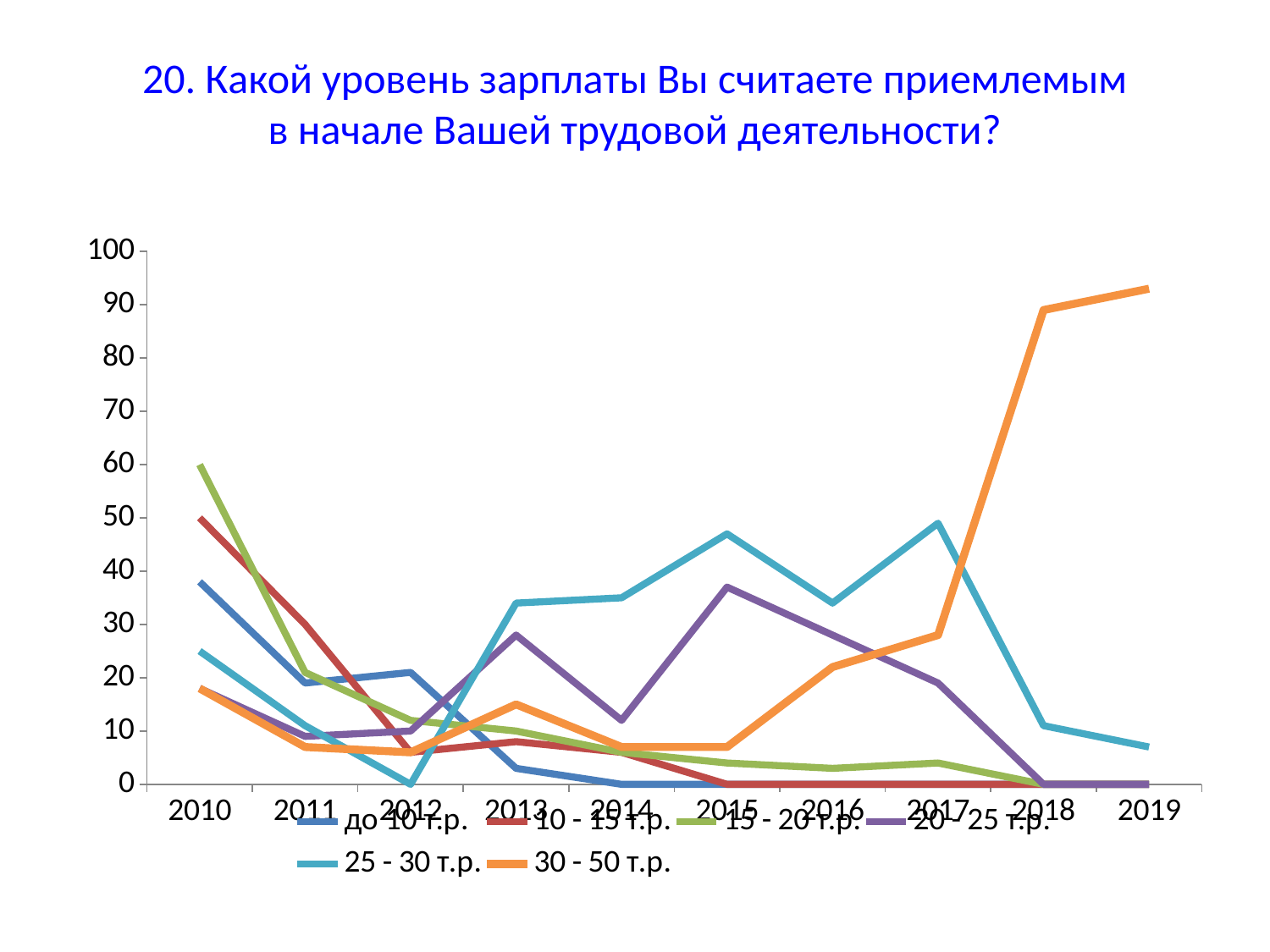
What is the value for до 10 т.р. in 2019? 0 How many series does the legend list? 6 Is the value for 25 - 30 т.р. in 2017 greater or less than 40? greater Which series has the highest value in 2010? 15 - 20 т.р. Is the value for 30 - 50 т.р. in 2019 greater or less than 90? greater Is the value for 20 - 25 т.р. in 2015 greater or less than 30? greater What kind of chart is shown on the slide? line chart How many years are shown along the x axis? 10 What is the value for 25 - 30 т.р. in 2012? 0 In 2015, which is larger: the value for 25 - 30 т.р. or the value for 20 - 25 т.р.? 25 - 30 т.р. Does the value for 30 - 50 т.р. rise or fall from 2017 to 2019? rise Which series has the highest value in 2019? 30 - 50 т.р.